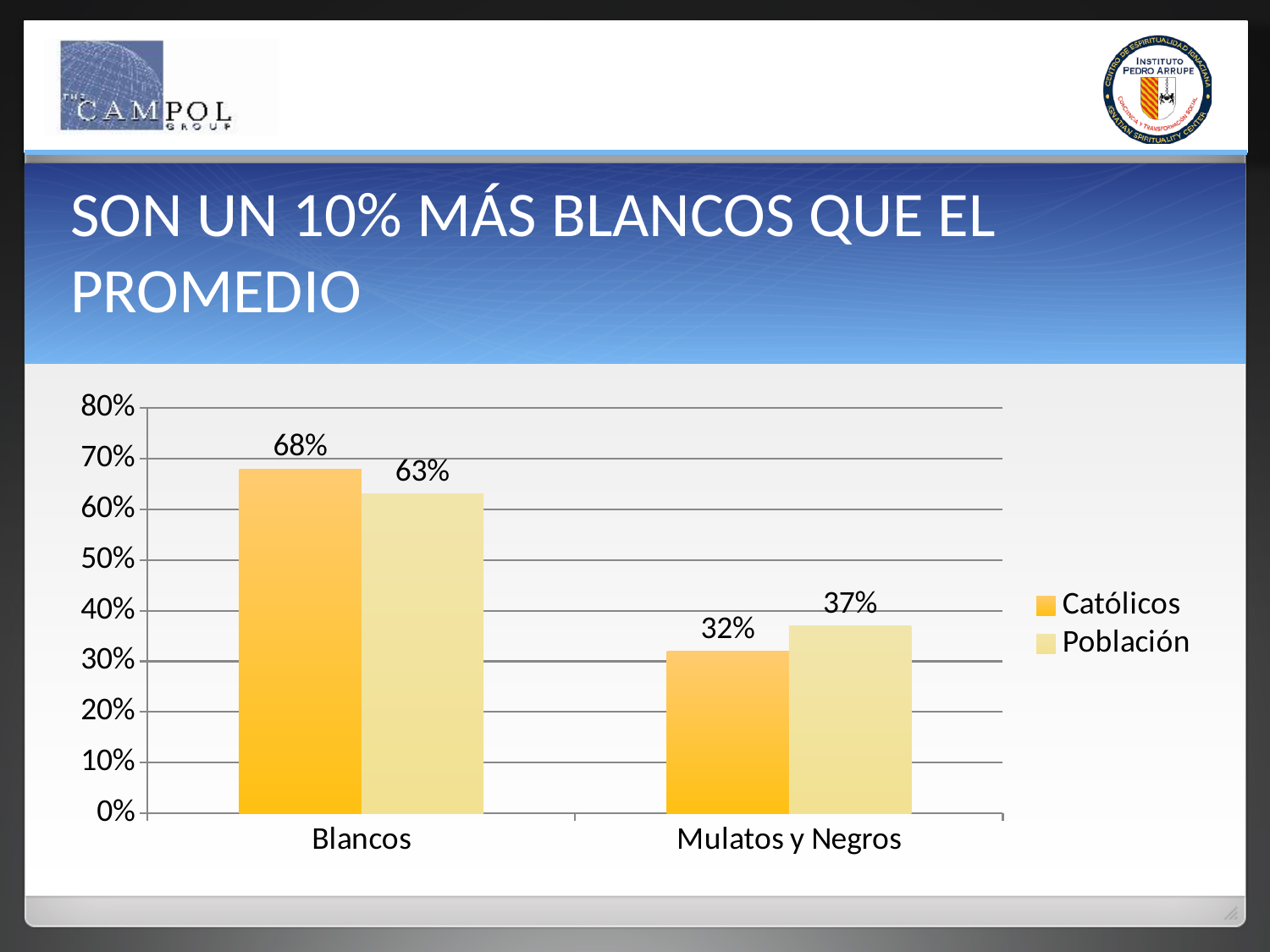
Which category has the highest Católicos value? Blancos What is the value for Población in the Blancos category? 63% What is the difference between the Católicos and Población values for Blancos? 5% How many series does the legend list? 2 For Mulatos y Negros, which is larger: Católicos or Población? Población How many categories are shown on the x axis? 2 Which category has the lowest Población value? Mulatos y Negros What kind of chart is shown on the slide? Bar chart What is the difference between the Población and Católicos values for Mulatos y Negros? 5% What is the value for Población in the Mulatos y Negros category? 37% What is the value for Católicos in the Mulatos y Negros category? 32% What is the value for Católicos in the Blancos category? 68%